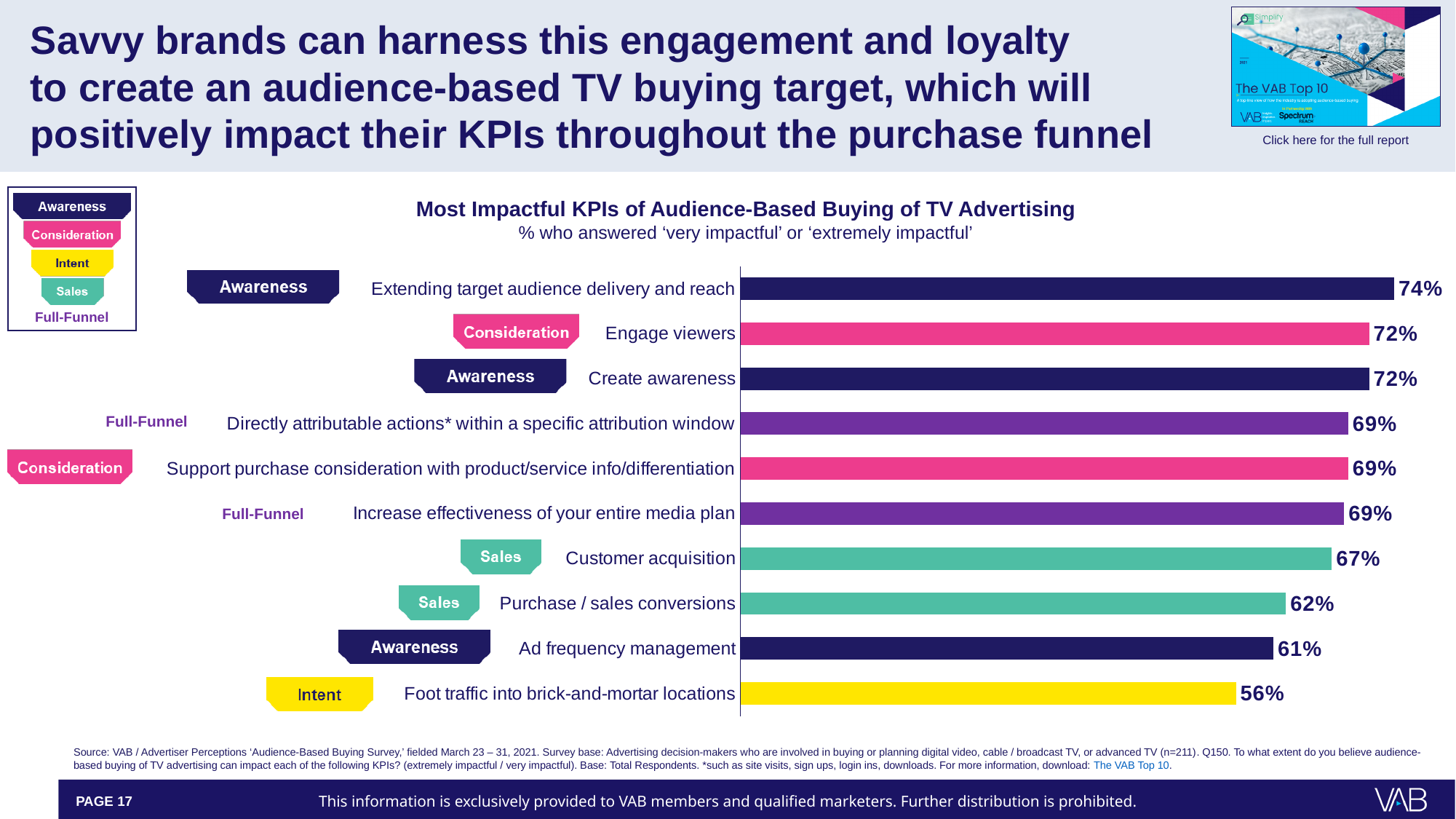
What type of chart is shown on the slide? Bar chart What is the difference in percentage points between 'Extending target audience delivery and reach' and 'Foot traffic into brick-and-mortar locations'? 18 What is the value shown for 'Ad frequency management'? 61% Which KPI has the highest percentage on the chart? Extending target audience delivery and reach What is the difference in percentage points between 'Customer acquisition' and 'Purchase / sales conversions'? 5 How many KPIs are plotted on the chart? 10 What is the value shown for 'Customer acquisition'? 67% Which has a higher value: 'Engage viewers' or 'Purchase / sales conversions'? Engage viewers What percentage of respondents rated 'Extending target audience delivery and reach' as very or extremely impactful? 74% What is the value shown for 'Foot traffic into brick-and-mortar locations'? 56% Which funnel stage label is attached to the 'Foot traffic into brick-and-mortar locations' bar? Intent Which KPI has the lowest percentage on the chart? Foot traffic into brick-and-mortar locations